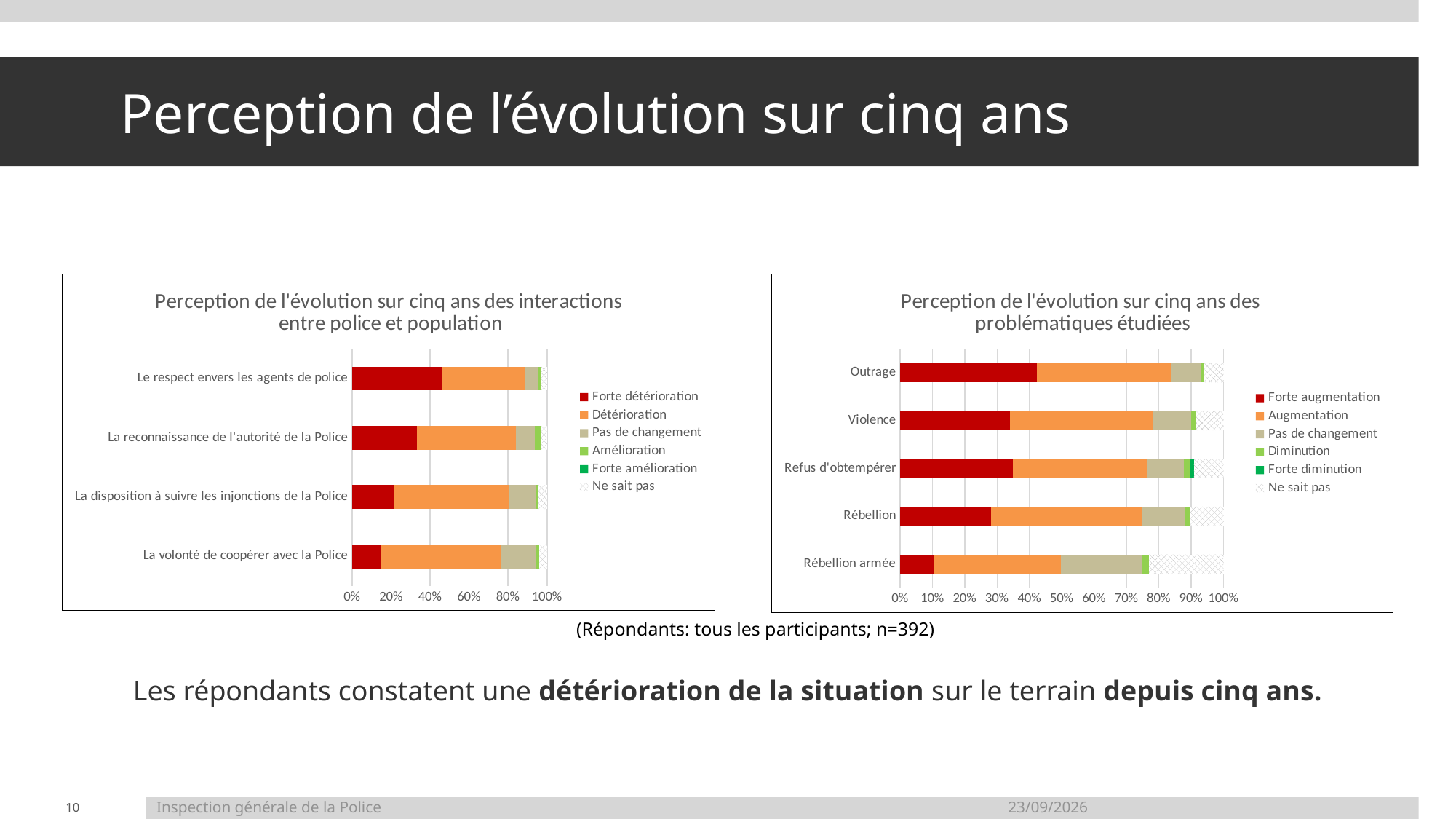
How many series does the legend of the right chart about 'problématiques étudiées' list? 6 On the left chart about interactions between police and population, is the 'Forte détérioration' share for 'La volonté de coopérer avec la Police' greater or less than 20%? less What kind of chart is the left chart, 'Perception de l'évolution sur cinq ans des interactions entre police et population'? Stacked bar chart How many categories are shown on the left chart about interactions between police and population? 4 On the left chart about interactions between police and population, which category has the smallest 'Forte détérioration' segment? La volonté de coopérer avec la Police On the right chart about 'problématiques étudiées', which is larger: the 'Forte augmentation' share for 'Outrage' or for 'Rébellion'? Outrage How many categories are shown on the right chart, 'Perception de l'évolution sur cinq ans des problématiques étudiées'? 5 How many series does the legend of the left chart about interactions between police and population list? 6 On the right chart about 'problématiques étudiées', which category has the largest 'Forte augmentation' segment? Outrage On the left chart about interactions between police and population, which category has the largest 'Forte détérioration' segment? Le respect envers les agents de police On the right chart about 'problématiques étudiées', is the 'Forte augmentation' share for 'Rébellion armée' greater or less than 20%? less On the left chart about interactions between police and population, is the 'Forte détérioration' share for 'Le respect envers les agents de police' greater or less than 40%? greater